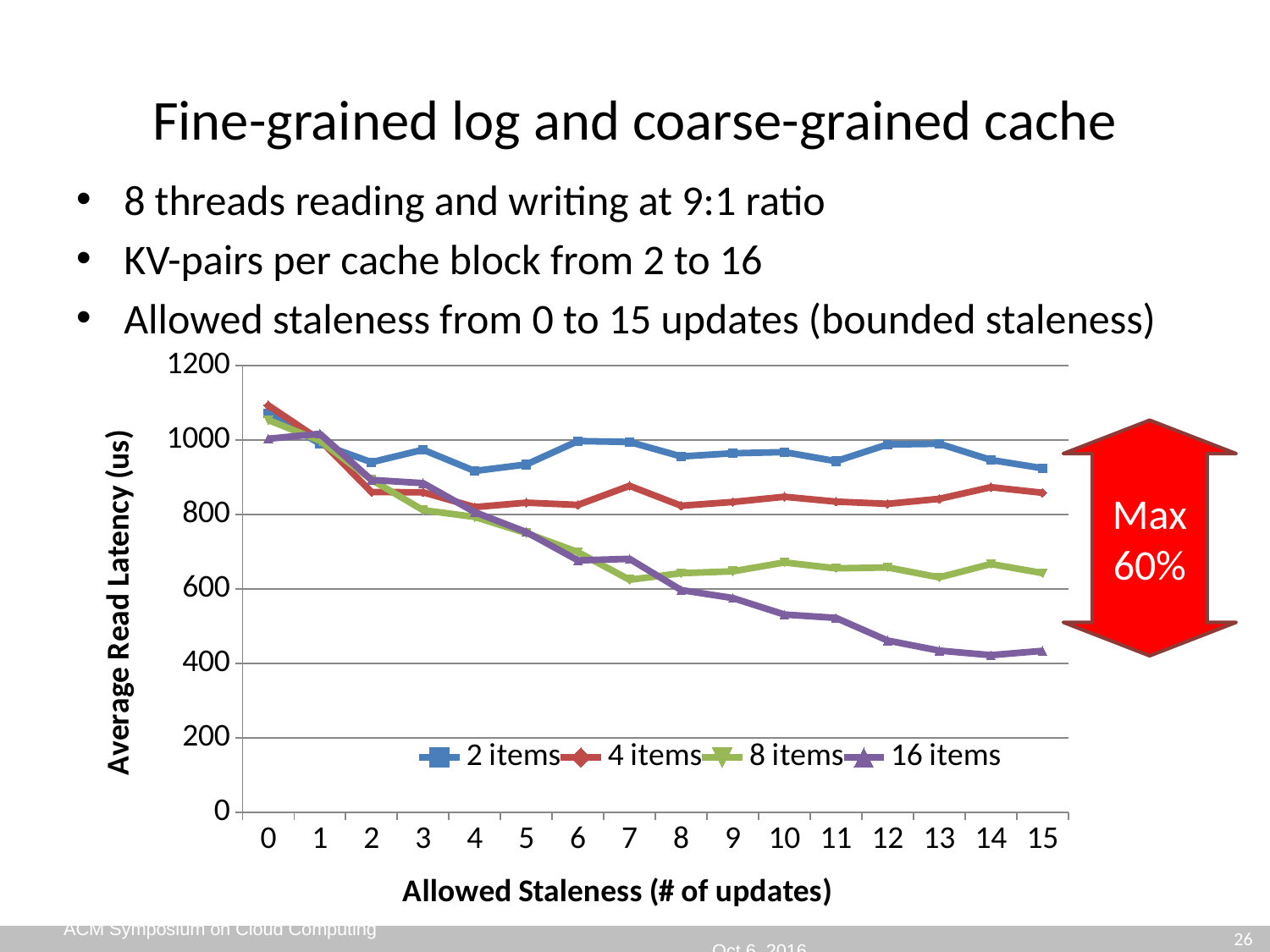
How many allowed staleness values are plotted along the x axis? 16 What kind of chart is shown on the slide? line chart Is the value for 2 items at allowed staleness 15 greater or less than 800? greater How many series does the chart's legend list? 4 Is the value for 8 items at allowed staleness 7 greater or less than 800? less Is the value for 4 items at allowed staleness 0 greater or less than 1000? greater Which series has the lowest average read latency at allowed staleness 15? 16 items What is the title of the chart's y axis? Average Read Latency (us) Which series has the highest average read latency at allowed staleness 10? 2 items At allowed staleness 15, which series has the larger average read latency, 2 items or 16 items? 2 items Does the average read latency for the 16 items series rise or fall as allowed staleness increases from 0 to 15? fall